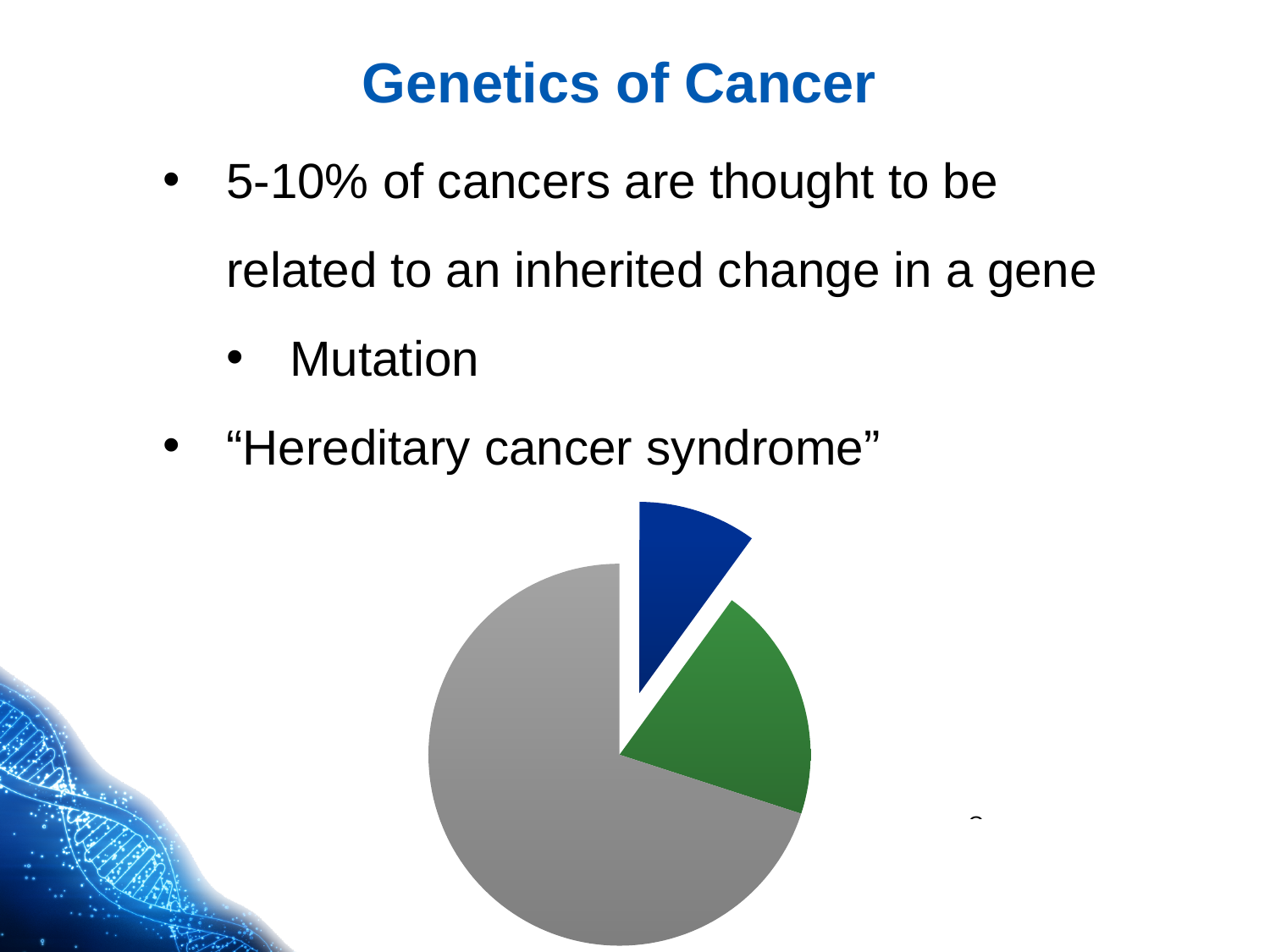
Which colour slice is the smallest in the pie chart? blue What kind of chart is shown on the slide? pie chart Does the pie chart have a legend? no Which is larger in the pie chart, the green slice or the blue slice? green How many slices does the pie chart have? 3 Which colour slice is pulled out (exploded) from the pie chart? blue Which colour slice is the largest in the pie chart? gray Which is larger in the pie chart, the gray slice or the green slice? gray